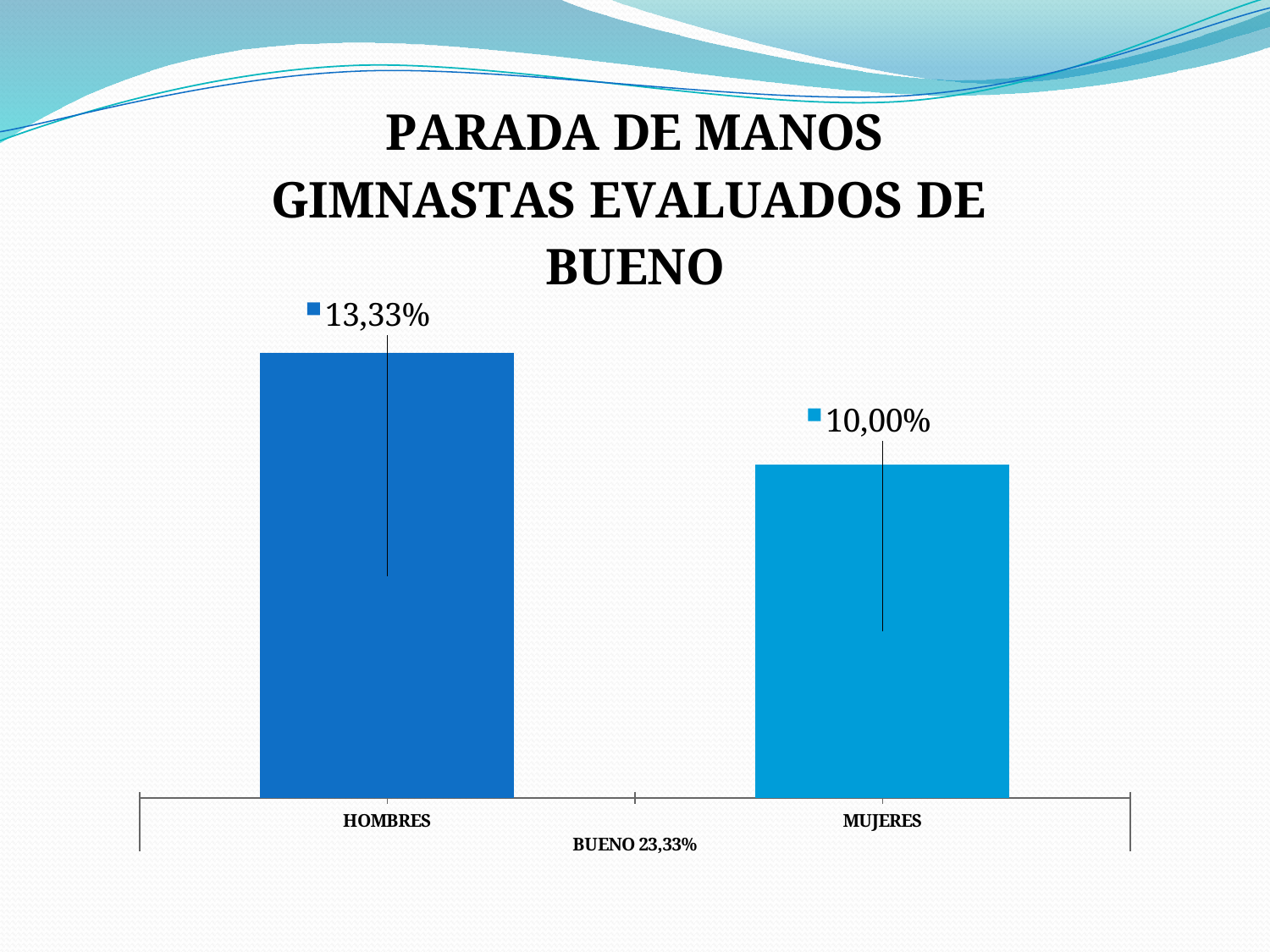
Which category has the highest value? HOMBRES Which is larger, the value for HOMBRES or the value for MUJERES? HOMBRES What kind of chart is shown on the slide? Bar chart What is the value for MUJERES? 10,00% What is the value for HOMBRES? 13,33% What label appears below the category axis? BUENO 23,33% What is the total of the two bars shown in the chart? 23,33% What is the difference between the values for HOMBRES and MUJERES? 3,33% How many categories are shown in the chart? 2 What is the title of the chart? PARADA DE MANOS GIMNASTAS EVALUADOS DE BUENO Which category has the lowest value? MUJERES